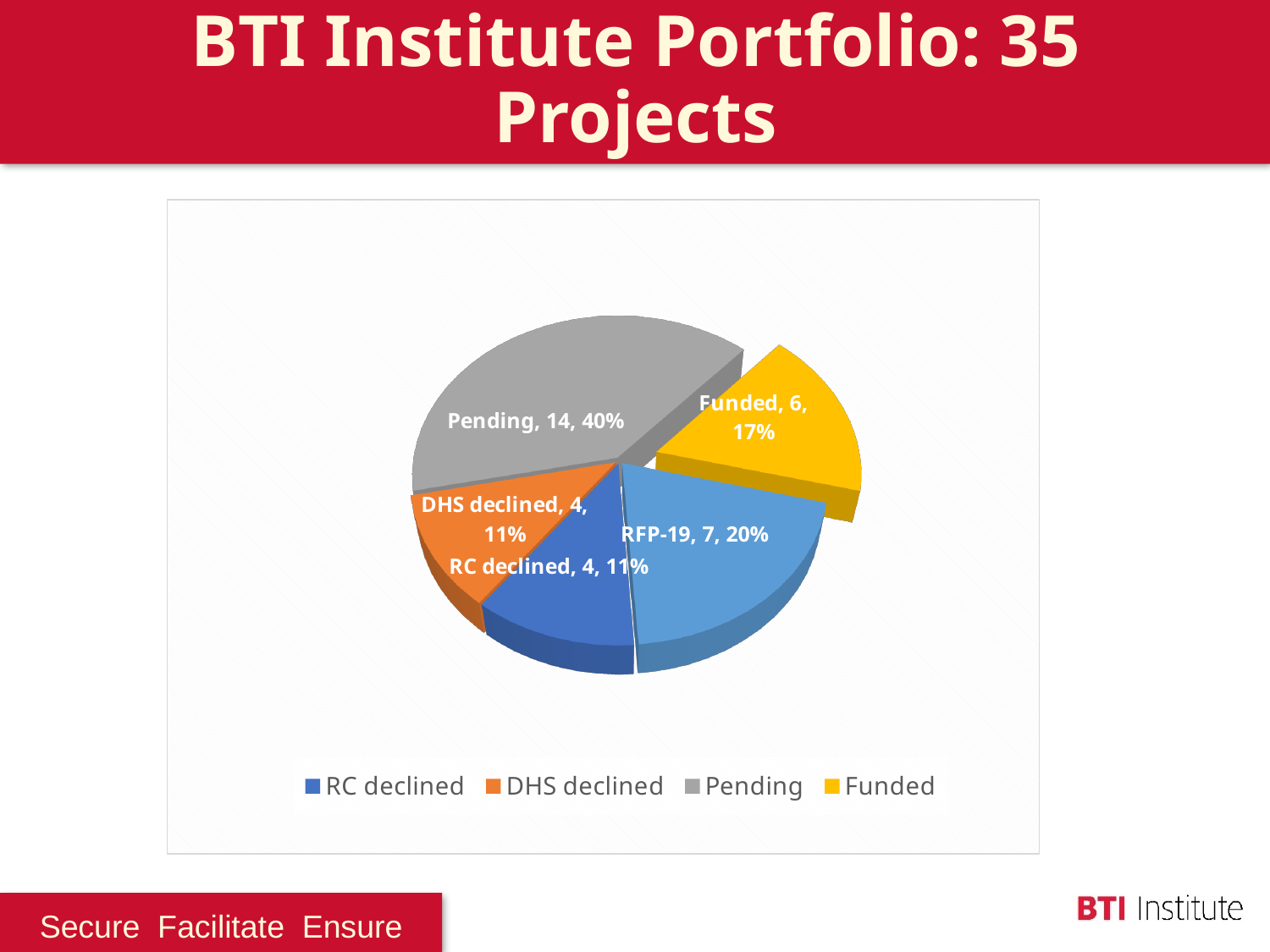
Which is larger, the RFP-19 slice or the Funded slice? RFP-19 What is the difference in number of projects between RFP-19 and DHS declined? 3 Which slice of the pie is the largest? Pending What kind of chart is shown on the slide? pie chart How many projects are in the RFP-19 slice? 7 What percentage of the pie is the RC declined slice? 11% How many projects are in the Pending slice? 14 How many slices does the pie chart have? 5 What colour is the Pending slice? grey What is the difference in number of projects between Pending and Funded? 8 How many entries does the legend list? 4 What percentage of the pie is the Funded slice? 17%